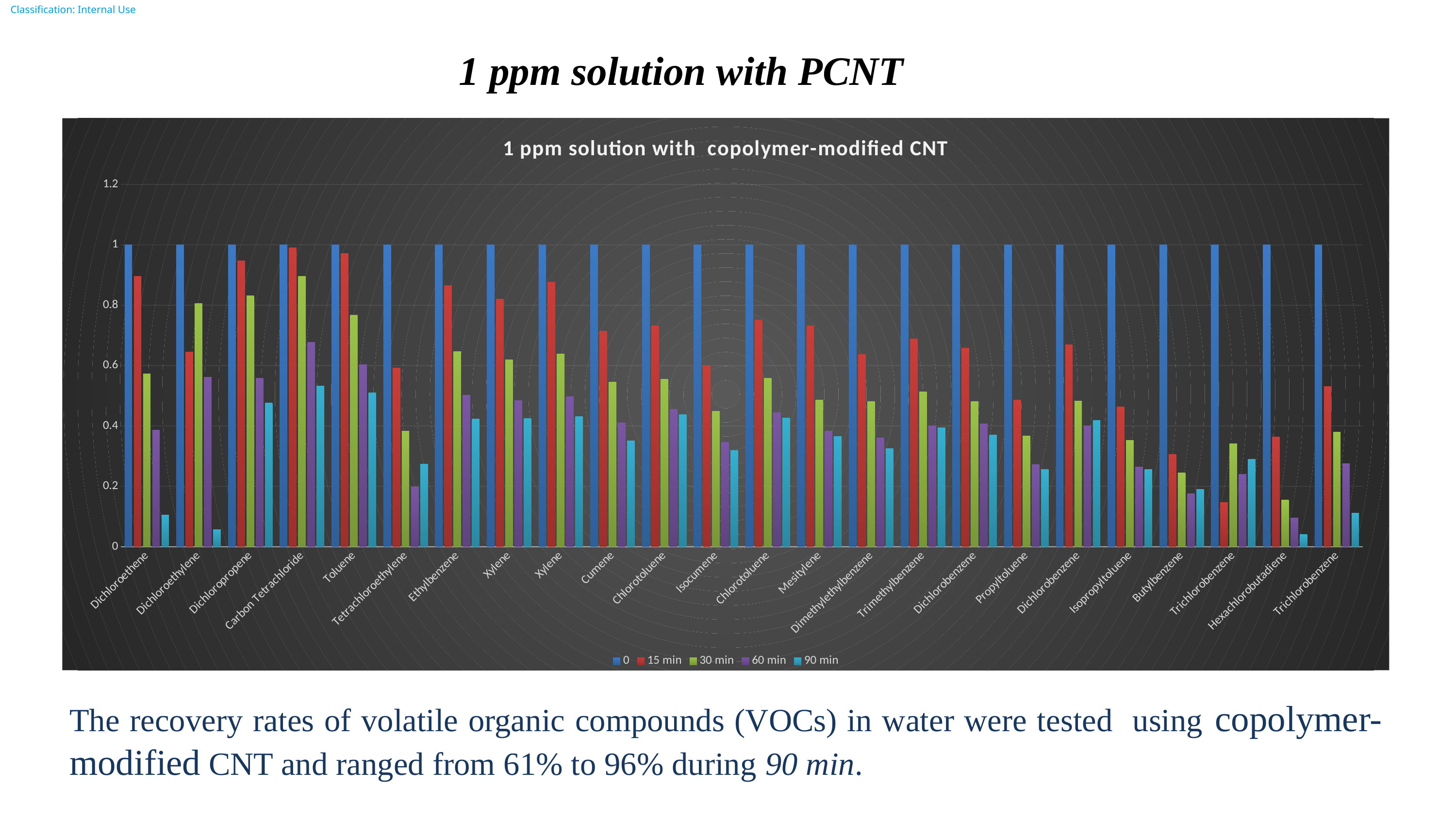
Is the 90 min value for Dichloroethylene greater or less than 0.2? less For Dichloroethene, do the values rise or fall from the 0 series through to the 90 min series? fall How many series does the chart legend list? 5 Is the 15 min value for Carbon Tetrachloride greater or less than 0.8? greater How many compound categories are plotted along the x axis? 24 Is the 60 min value for Tetrachloroethylene greater or less than 0.4? less Which has the larger 15 min value, Dichloroethene or Dichloroethylene? Dichloroethene Which category has the highest 30 min value? Carbon Tetrachloride What is the title printed inside the chart area? 1 ppm solution with copolymer-modified CNT What kind of chart is shown on the slide? Bar chart What is the value of the "0" series for Toluene? 1